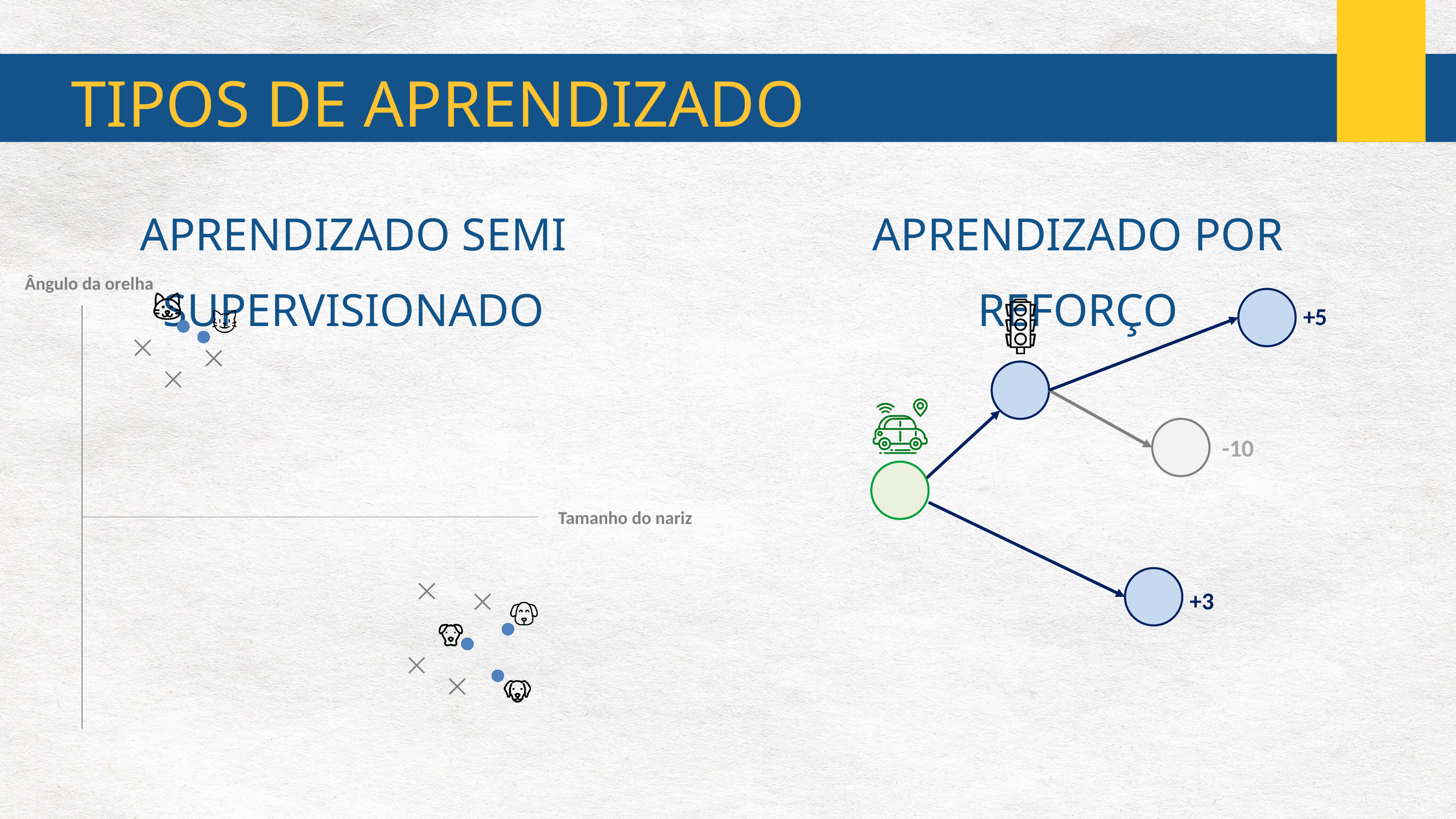
What kind of chart is shown under the heading 'Aprendizado semi supervisionado' on the left of the slide? scatter plot In the left-hand scatter plot, how many blue dots are plotted in total? 5 In the left-hand scatter plot, how many blue dots are in the lower-right cluster (near the dog icons)? 3 In the right-hand diagram under 'Aprendizado por reforço', which labelled node has the highest value? +5 In the right-hand diagram under 'Aprendizado por reforço', which labelled node has the lowest value? -10 In the left-hand scatter plot, what is the label of the vertical axis? Ângulo da orelha In the right-hand diagram under 'Aprendizado por reforço', what value is written next to the bottom node? +3 In the right-hand diagram under 'Aprendizado por reforço', what value is written next to the grey node? -10 In the left-hand scatter plot, how many X marks are plotted in total? 7 In the right-hand diagram under 'Aprendizado por reforço', what is the difference between the +5 node and the +3 node? 2 In the left-hand scatter plot, what is the label of the horizontal axis? Tamanho do nariz In the right-hand diagram under 'Aprendizado por reforço', what value is written next to the top-right node? +5